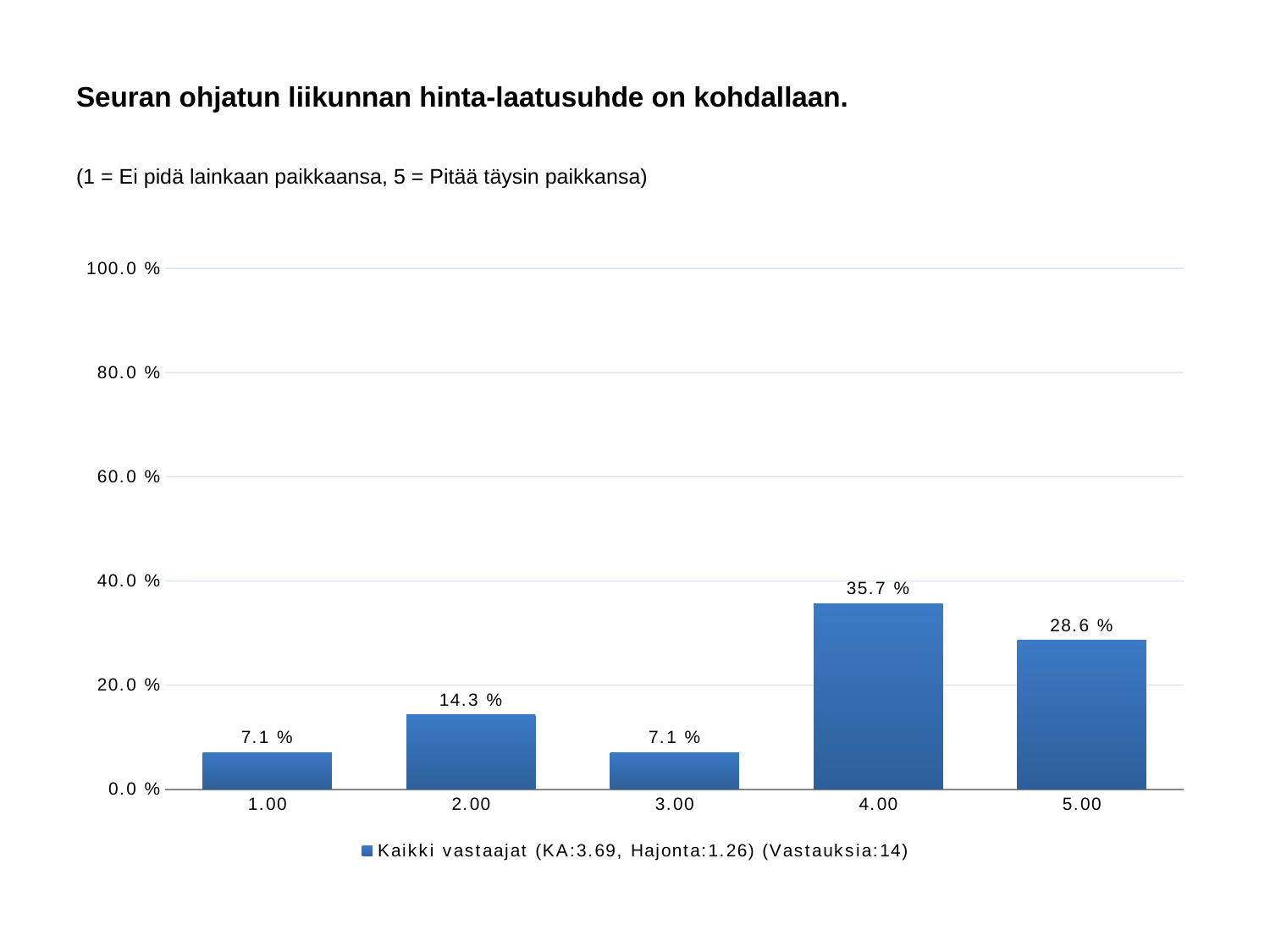
How many responses (Vastauksia) does the legend state? 14 What is the value for category 5.00? 28.6 % What is the value for category 2.00? 14.3 % What is the value for category 4.00? 35.7 % What is the total of the values for 1.00 and 3.00? 14.2 % How many categories are shown on the x axis? 5 How many series does the legend list? 1 What kind of chart is shown? bar chart Is the value for 4.00 greater or less than 40.0 %? less Which category has the highest value? 4.00 Which is larger, the value for 2.00 or the value for 3.00? 2.00 What is the difference between the values for 4.00 and 5.00? 7.1 %